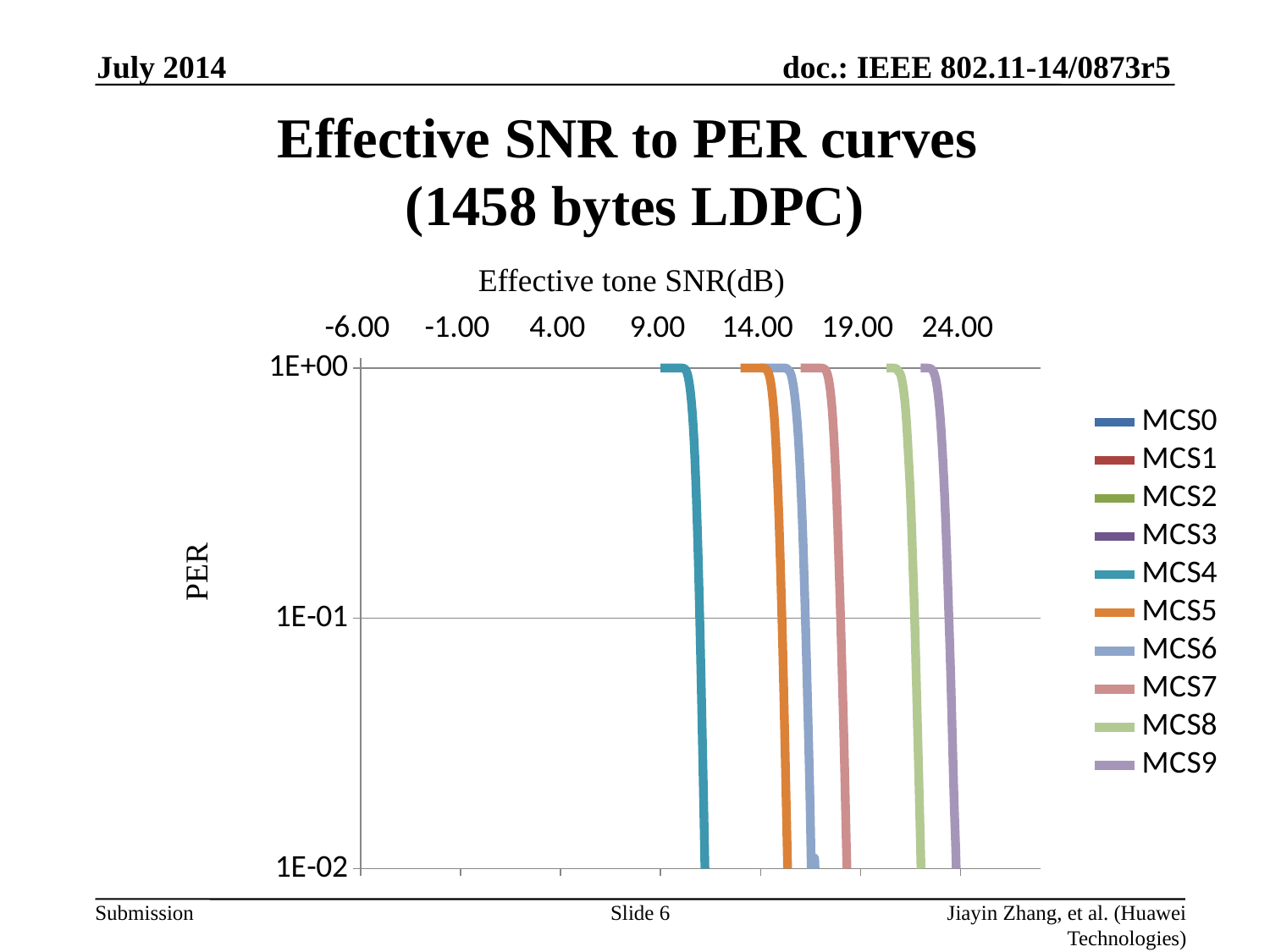
Which series reaches a PER of 1E-01 at a lower SNR, MCS4 or MCS7? MCS4 Which series' curve lies furthest to the right, i.e. requires the highest SNR to reach a given PER? MCS9 Among the curves visible on the chart, which series' curve lies furthest to the left? MCS4 What is the title of the chart? Effective SNR to PER curves (1458 bytes LDPC) Which series reaches a PER of 1E-01 at a higher SNR, MCS8 or MCS5? MCS8 What is the label of the horizontal axis? Effective tone SNR(dB) Is the SNR at which the MCS4 curve reaches a PER of 1E-01 greater or less than 14.00 dB? less Is the SNR at which the MCS7 curve reaches a PER of 1E-01 greater or less than 19.00 dB? less What kind of chart is shown on the slide? line chart Is the SNR at which the MCS9 curve reaches a PER of 1E-01 greater or less than 19.00 dB? greater How many series does the legend list? 10 As the effective tone SNR increases along the x axis, does the PER for each curve rise or fall? fall